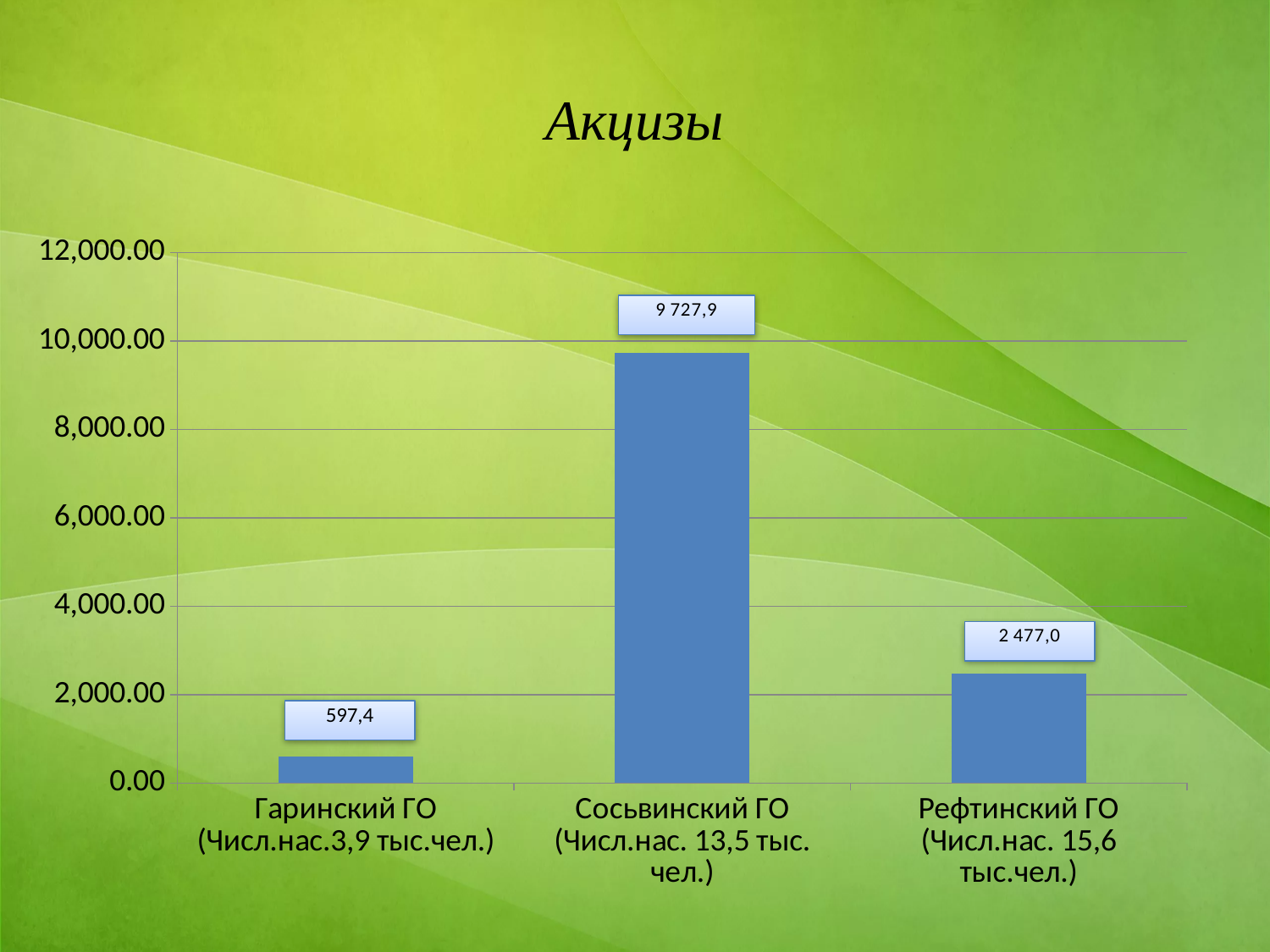
What is the difference between the values for Сосьвинский ГО and Рефтинский ГО? 7 250,9 How many categories are shown on the chart? 3 Is the value for Сосьвинский ГО greater or less than 8,000.00? greater Is the value for Рефтинский ГО greater or less than 4,000.00? less Which category has the lowest value? Гаринский ГО Which is larger, the value for Рефтинский ГО or the value for Гаринский ГО? Рефтинский ГО What is the difference between the values for Рефтинский ГО and Гаринский ГО? 1 879,6 What is the value for Рефтинский ГО? 2 477,0 What kind of chart is shown on the slide? bar chart What is the value for Гаринский ГО? 597,4 Which category has the highest value? Сосьвинский ГО What is the value for Сосьвинский ГО? 9 727,9